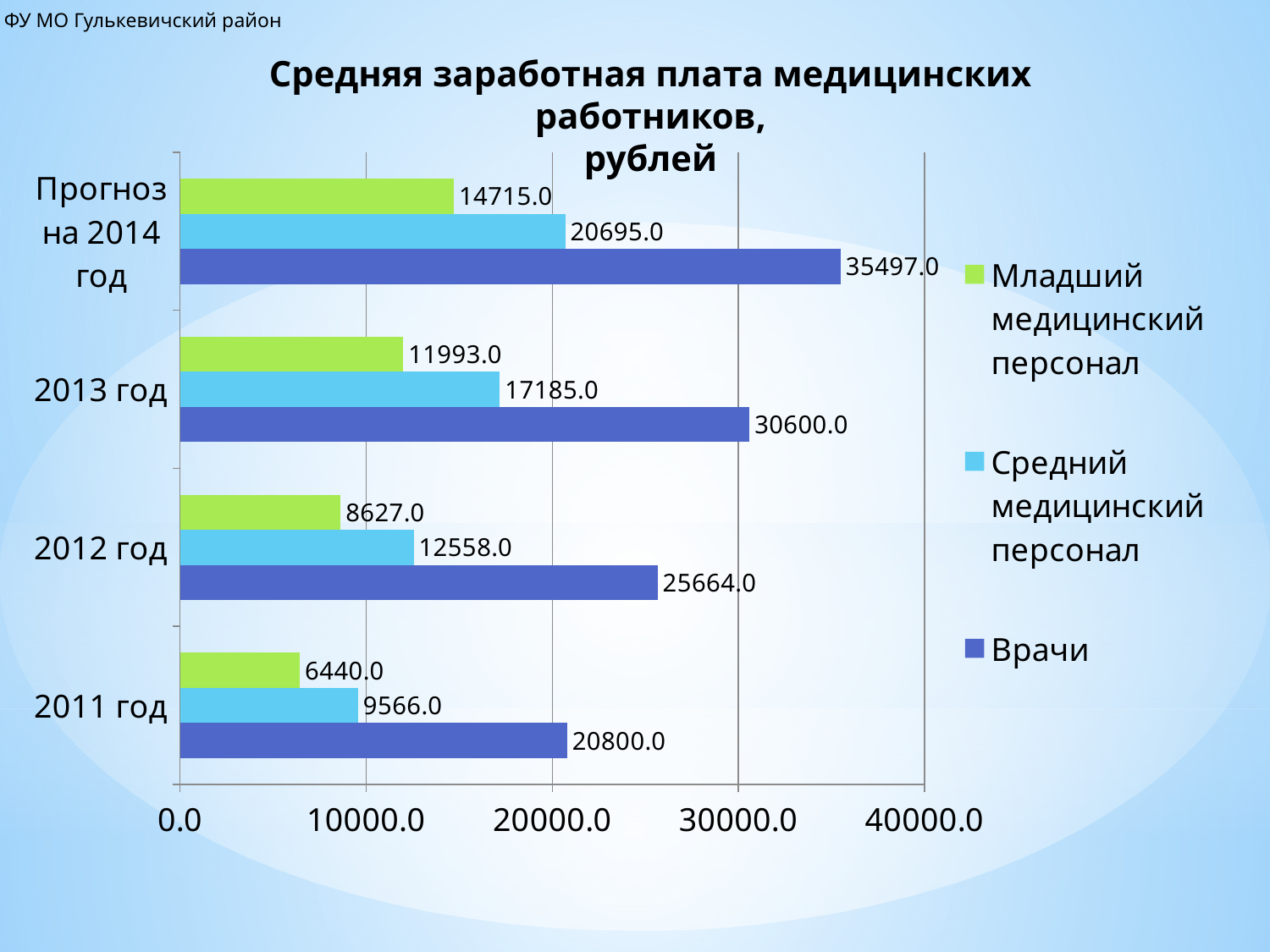
What is the difference between the Врачи value and the Младший медицинский персонал value in 2012 год? 17037.0 Which is larger: the Средний медицинский персонал value in 2013 год or the Младший медицинский персонал value in Прогноз на 2014 год? Средний медицинский персонал in 2013 год In which year is the value for Средний медицинский персонал the lowest? 2011 год Is the value for Врачи in 2011 год greater or less than 20000.0? greater Do the values for Младший медицинский персонал rise or fall from 2011 год to Прогноз на 2014 год? Rise What is the value for Младший медицинский персонал in 2011 год? 6440.0 What is the value for Средний медицинский персонал in Прогноз на 2014 год? 20695.0 What kind of chart is shown on the slide? Bar chart What is the average salary of Врачи in 2013 год? 30600.0 How many year categories are shown on the chart? 4 How many series does the legend list? 3 In which year is the value for Врачи the highest? Прогноз на 2014 год